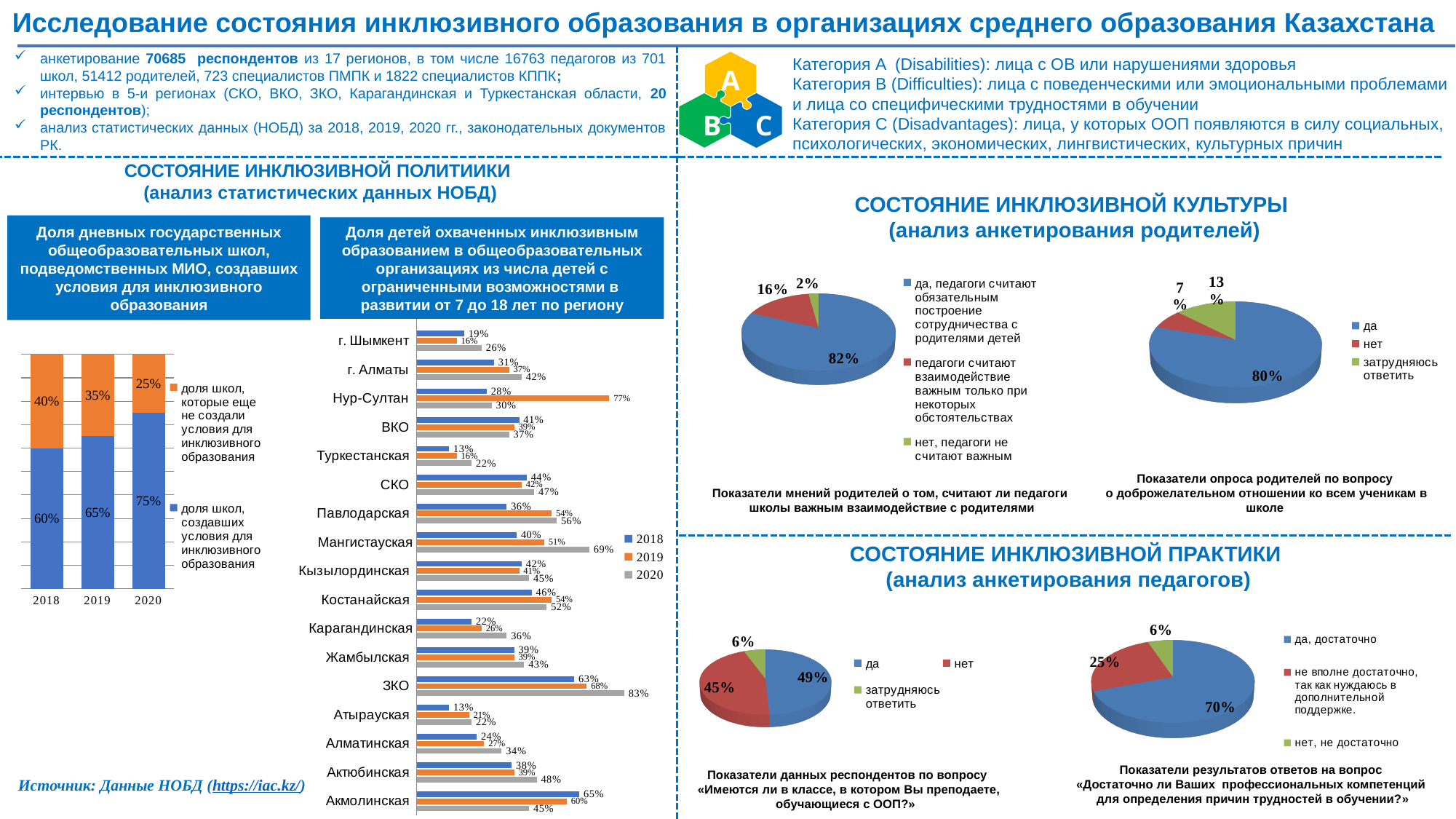
In the pie chart on parents' survey about a friendly attitude towards all students in the school, what share answered 'нет'? 7% In the horizontal bar chart on the share of children covered by inclusive education by region, how many series does the legend list? 3 In the horizontal bar chart on the share of children covered by inclusive education by region, which region has the highest value in 2020? ЗКО In the horizontal bar chart on the share of children covered by inclusive education by region, what is the difference between the 2020 and 2018 values for Мангистауская? 29% In the horizontal bar chart on the share of children covered by inclusive education by region, what is the value for Нур-Султан in 2019? 77% In the pie chart on parents' opinions about whether teachers consider cooperation with parents important, what share answered that teachers consider building cooperation with parents mandatory? 82% What type of chart is used to show the results on whether teachers' professional competencies are sufficient to determine the causes of learning difficulties? pie chart In the horizontal bar chart on the share of children covered by inclusive education by region, how many regions are shown? 17 In the stacked bar chart on the share of day state schools, does the share of schools that created conditions for inclusive education rise or fall from 2018 to 2020? rise In the stacked bar chart on the share of day state schools that created conditions for inclusive education, what is the share of schools that created conditions in 2020? 75% In the pie chart on whether there are students with special educational needs in the class where the teacher teaches, which is larger: 'да' or 'нет'? да In the stacked bar chart on the share of day state schools, what is the share of schools that have not yet created conditions for inclusive education in 2018? 40%